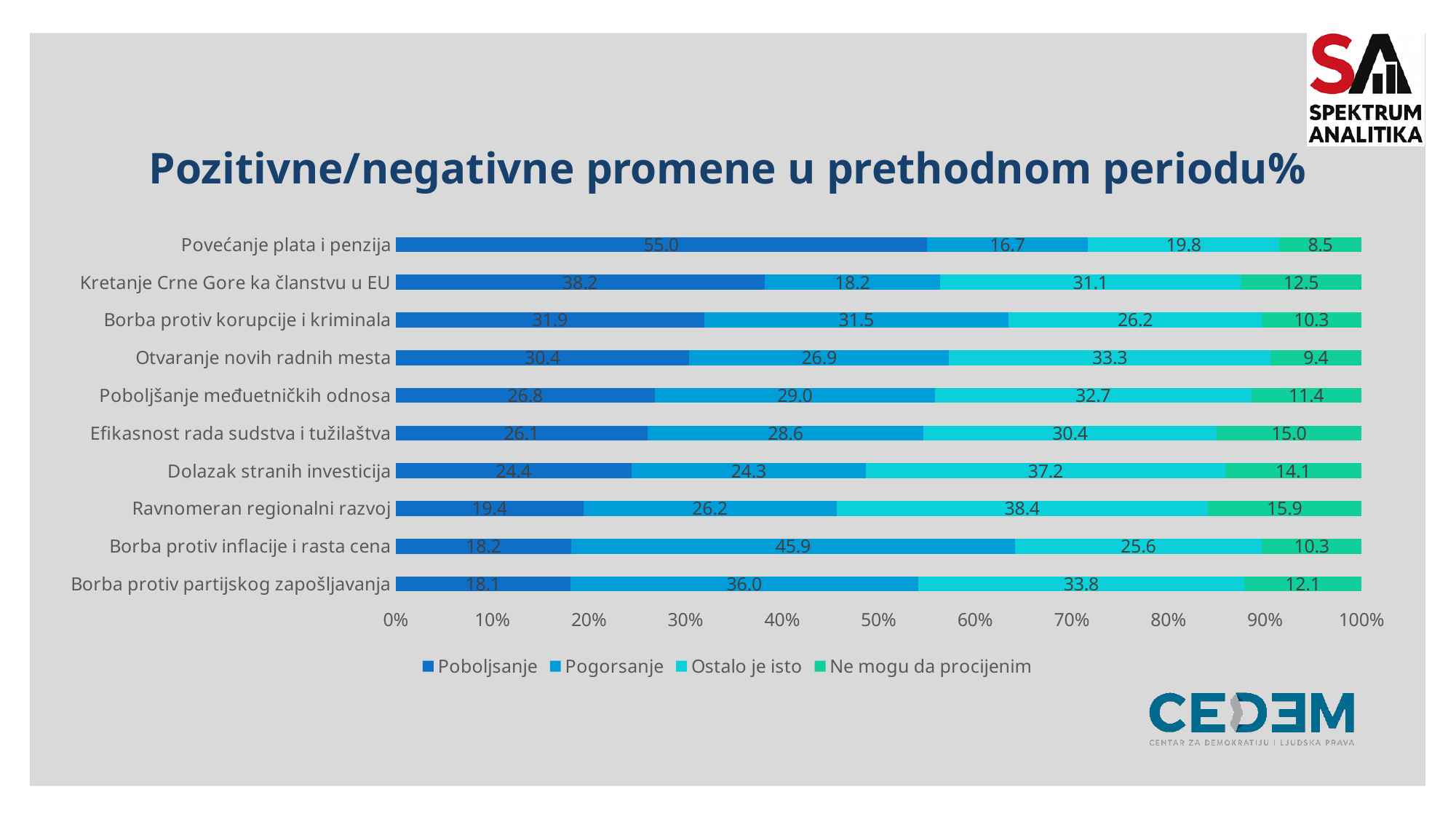
Which is larger: the Pogorsanje value for Borba protiv korupcije i kriminala or for Otvaranje novih radnih mesta? Borba protiv korupcije i kriminala Which category has the highest Poboljsanje value? Povećanje plata i penzija What is the Poboljsanje value for Povećanje plata i penzija? 55.0 What is the Ne mogu da procijenim value for Efikasnost rada sudstva i tužilaštva? 15.0 How many categories are shown on the chart? 10 Which category has the lowest Poboljsanje value? Borba protiv partijskog zapošljavanja What is the Pogorsanje value for Borba protiv inflacije i rasta cena? 45.9 What is the title of the chart? Pozitivne/negativne promene u prethodnom periodu% What is the Ostalo je isto value for Ravnomeran regionalni razvoj? 38.4 What kind of chart is shown on the slide? Stacked bar chart What is the difference between the Poboljsanje values for Povećanje plata i penzija and Kretanje Crne Gore ka članstvu u EU? 16.8 How many series does the legend list? 4